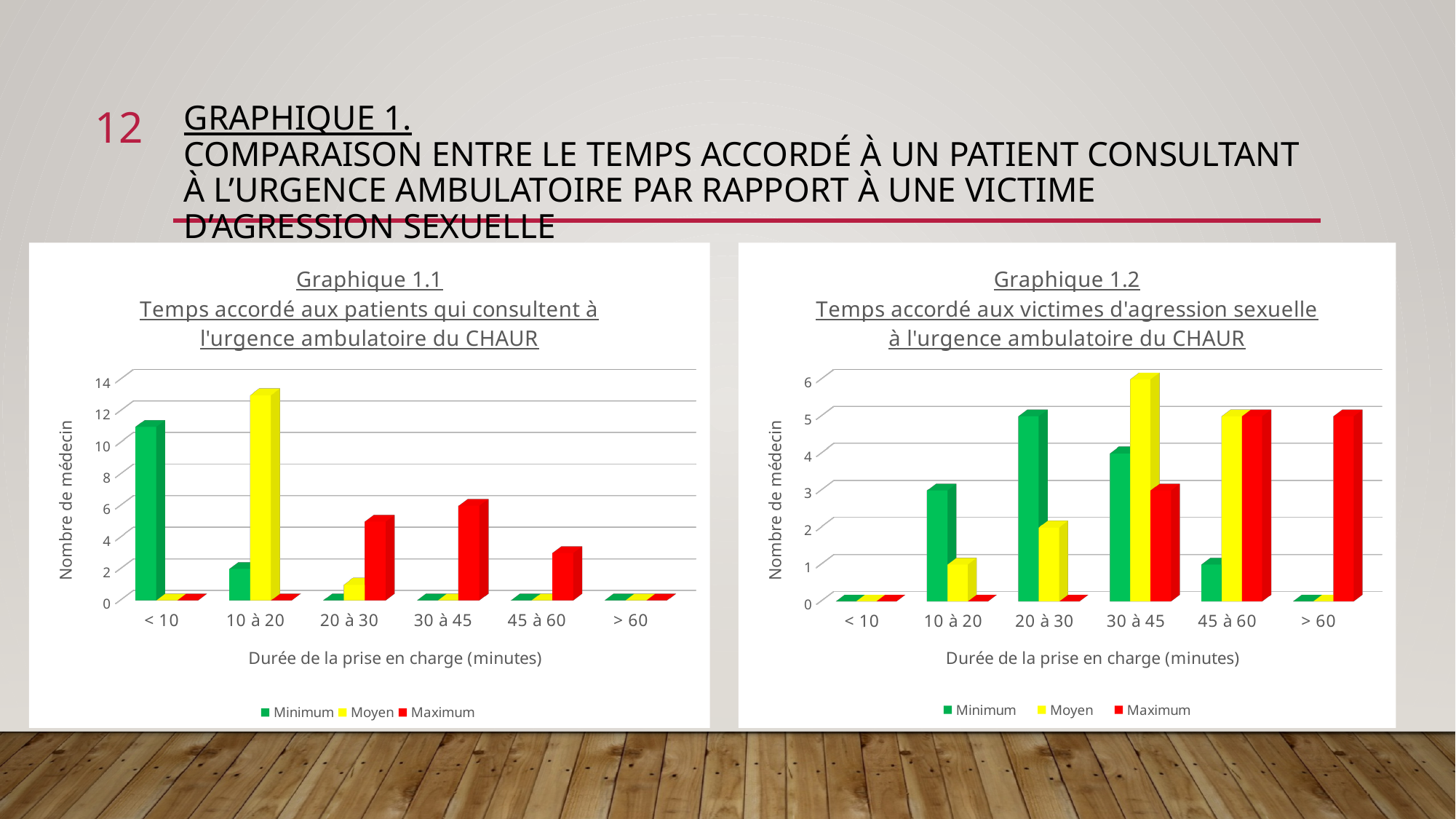
How many duration categories are shown on the x axis of Graphique 1.1? 6 In Graphique 1.1, is the Moyen value for 10 à 20 greater or less than 12? greater In Graphique 1.2, is the Minimum value for 20 à 30 greater or less than 4? greater How many series does the legend of Graphique 1.2 list? 3 What kind of chart is Graphique 1.1? bar chart What is the x-axis title of Graphique 1.2? Durée de la prise en charge (minutes) In Graphique 1.2, which is larger: the Minimum value for 10 à 20 or the Minimum value for 45 à 60? 10 à 20 In Graphique 1.1, which duration category has the highest Minimum value? < 10 In Graphique 1.1, is the Maximum value for 45 à 60 greater or less than 4? less In Graphique 1.1, which is larger: the Maximum value for 20 à 30 or the Maximum value for 30 à 45? 30 à 45 In Graphique 1.2, which duration category has the highest Moyen value? 30 à 45 In Graphique 1.1, which duration category has the highest Moyen value? 10 à 20